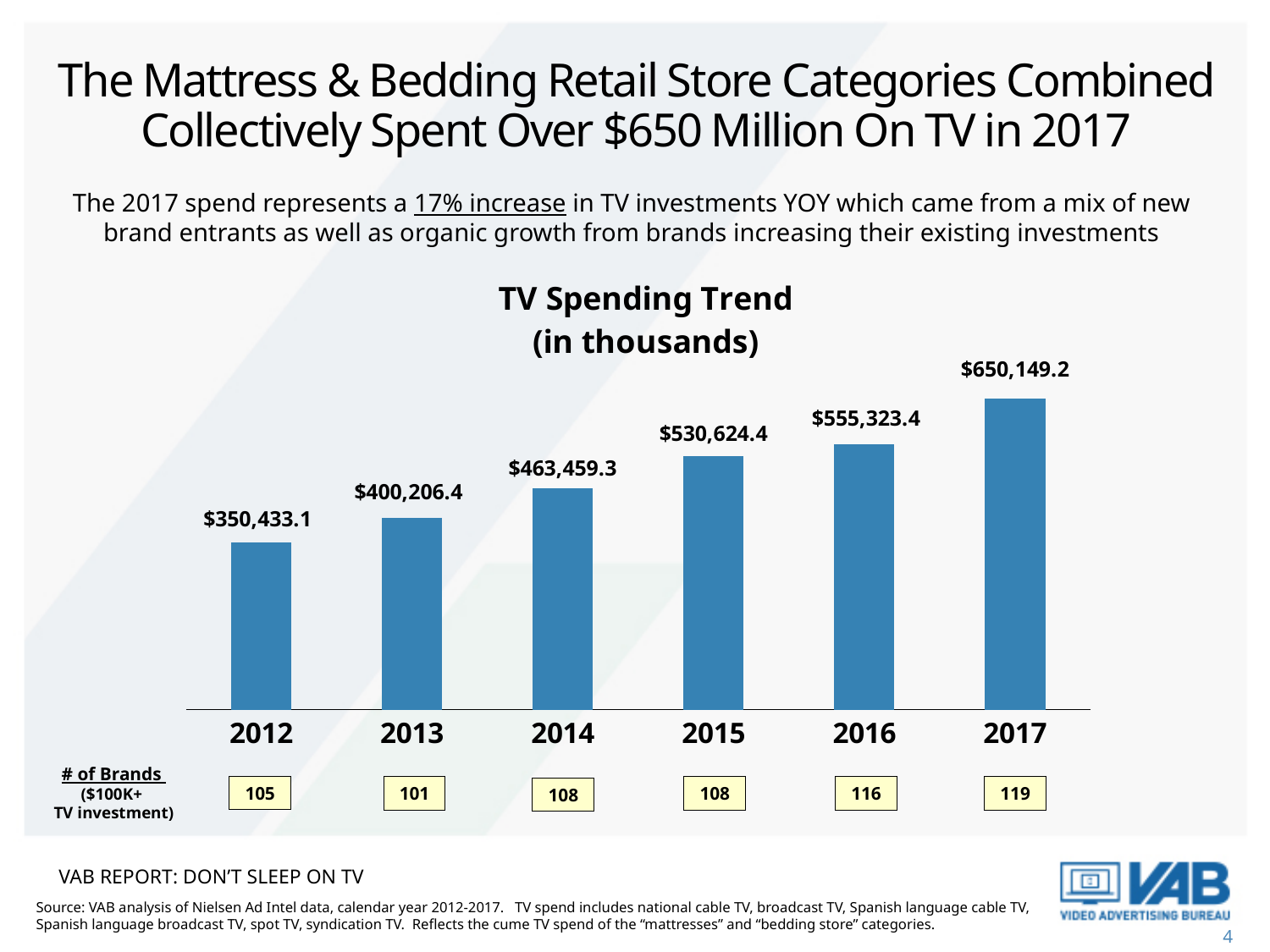
What is the TV spending value shown for 2012 in the TV Spending Trend chart? $350,433.1 What is the difference between the 2017 and 2016 values in the TV Spending Trend chart? $94,825.8 What is the TV spending value shown for 2017 in the TV Spending Trend chart? $650,149.2 What is the TV spending value shown for 2016 in the TV Spending Trend chart? $555,323.4 Which year has the highest TV spending in the TV Spending Trend chart? 2017 What is the TV spending value shown for 2014 in the TV Spending Trend chart? $463,459.3 What is the difference between the 2013 and 2012 values in the TV Spending Trend chart? $49,773.3 Which year has the lowest TV spending in the TV Spending Trend chart? 2012 How many years are shown in the TV Spending Trend chart? 6 What kind of chart is the TV Spending Trend chart? Bar chart Do the values in the TV Spending Trend chart rise or fall from 2012 to 2017? Rise In the TV Spending Trend chart, which year has the larger value, 2015 or 2016? 2016